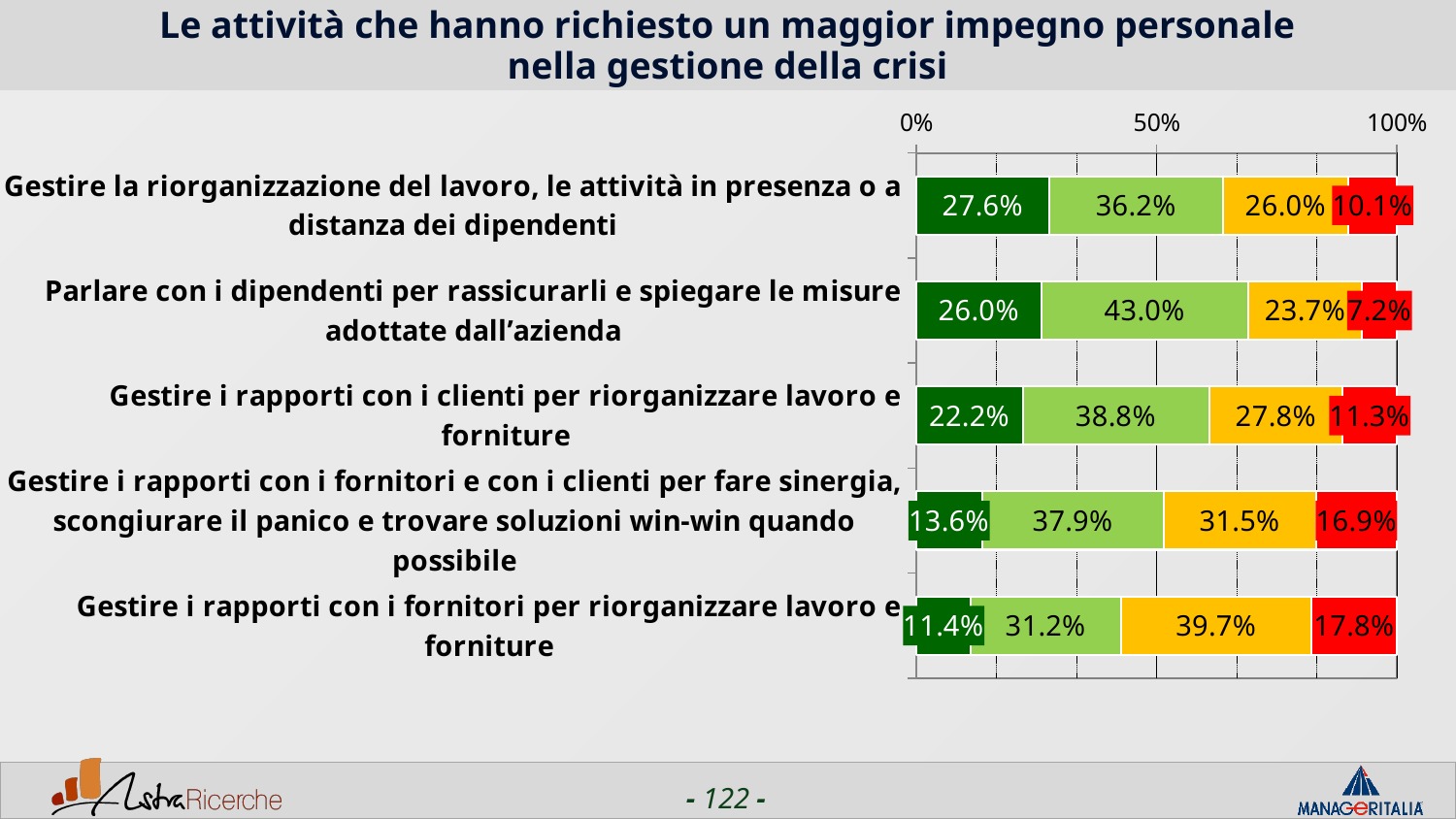
What is the value of the light green segment for 'Parlare con i dipendenti per rassicurarli e spiegare le misure adottate dall'azienda'? 43.0% What is the value of the yellow segment for 'Gestire i rapporti con i fornitori per riorganizzare lavoro e forniture'? 39.7% What type of chart is shown on the slide? Stacked bar chart How many activities (categories) are listed in the chart? 5 What is the value of the red segment for 'Gestire i rapporti con i fornitori e con i clienti per fare sinergia, scongiurare il panico e trovare soluzioni win-win quando possibile'? 16.9% What is the difference between the light green values for 'Parlare con i dipendenti per rassicurarli e spiegare le misure adottate dall'azienda' and 'Gestire i rapporti con i fornitori per riorganizzare lavoro e forniture'? 11.8% What is the total of the four segments for 'Gestire i rapporti con i clienti per riorganizzare lavoro e forniture'? 100.1% How many coloured segments make up each bar in the chart? 4 Which is larger: the yellow value for 'Gestire i rapporti con i clienti per riorganizzare lavoro e forniture' or the yellow value for 'Gestire la riorganizzazione del lavoro, le attività in presenza o a distanza dei dipendenti'? Gestire i rapporti con i clienti per riorganizzare lavoro e forniture Which activity has the lowest red value? Parlare con i dipendenti per rassicurarli e spiegare le misure adottate dall'azienda Which activity has the highest dark green value? Gestire la riorganizzazione del lavoro, le attività in presenza o a distanza dei dipendenti What is the value of the dark green segment for 'Gestire la riorganizzazione del lavoro, le attività in presenza o a distanza dei dipendenti'? 27.6%